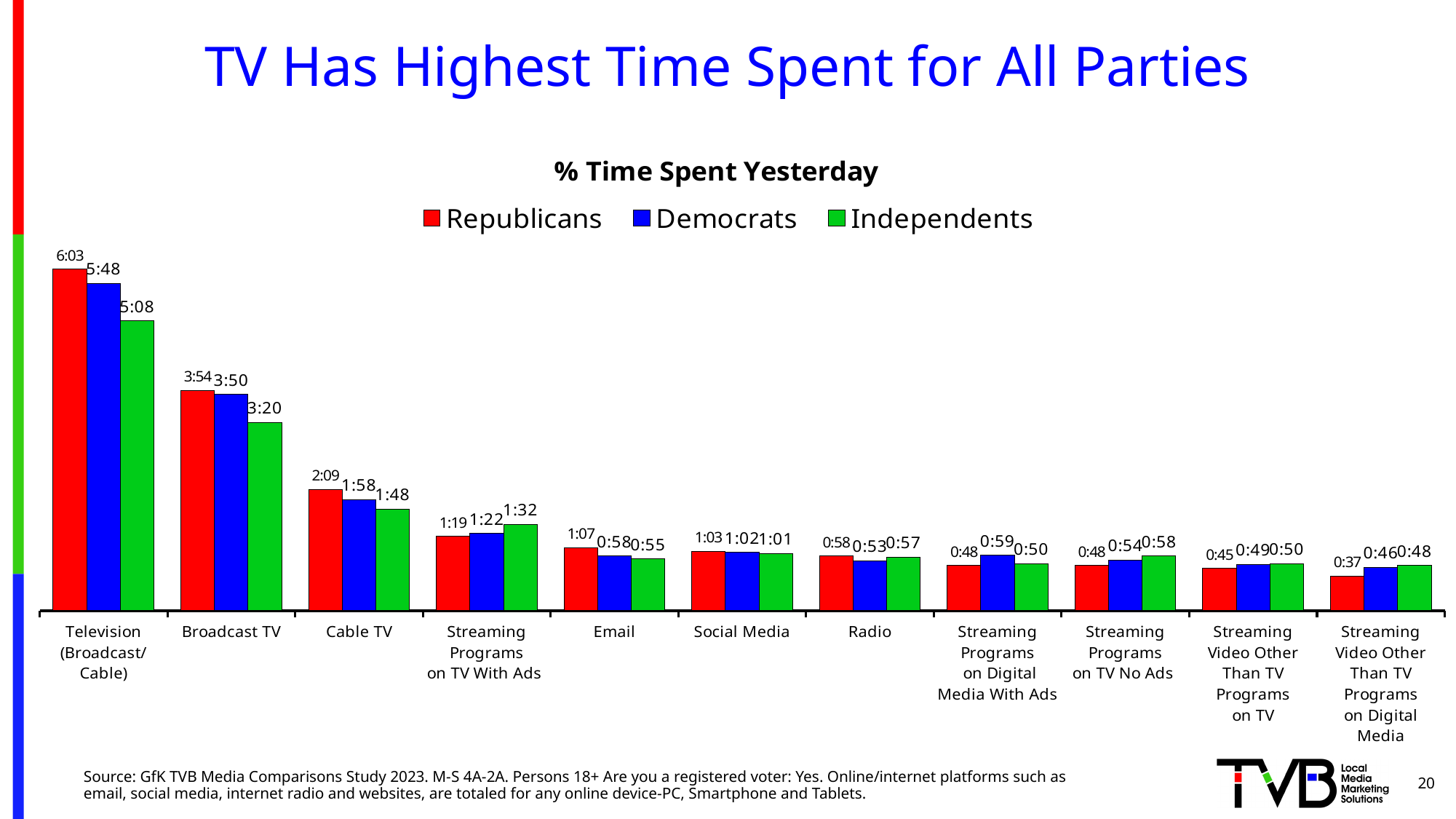
Which category has the highest value for Independents? Television (Broadcast/Cable) What is the difference between the Republicans and Independents values for Television (Broadcast/Cable)? 0:55 What is the title of the chart? % Time Spent Yesterday Which category has the lowest value for Republicans? Streaming Video Other Than TV Programs on Digital Media What kind of chart is shown on the slide? Bar chart Which is larger in the Email category, the Republicans value or the Democrats value? Republicans How many series does the legend list? 3 What is the value for Democrats in the Cable TV category? 1:58 What is the value for Democrats in the Social Media category? 1:02 What is the value for Independents in the Streaming Programs on TV With Ads category? 1:32 How many categories are shown on the x axis? 11 What is the value for Republicans in the Television (Broadcast/Cable) category? 6:03